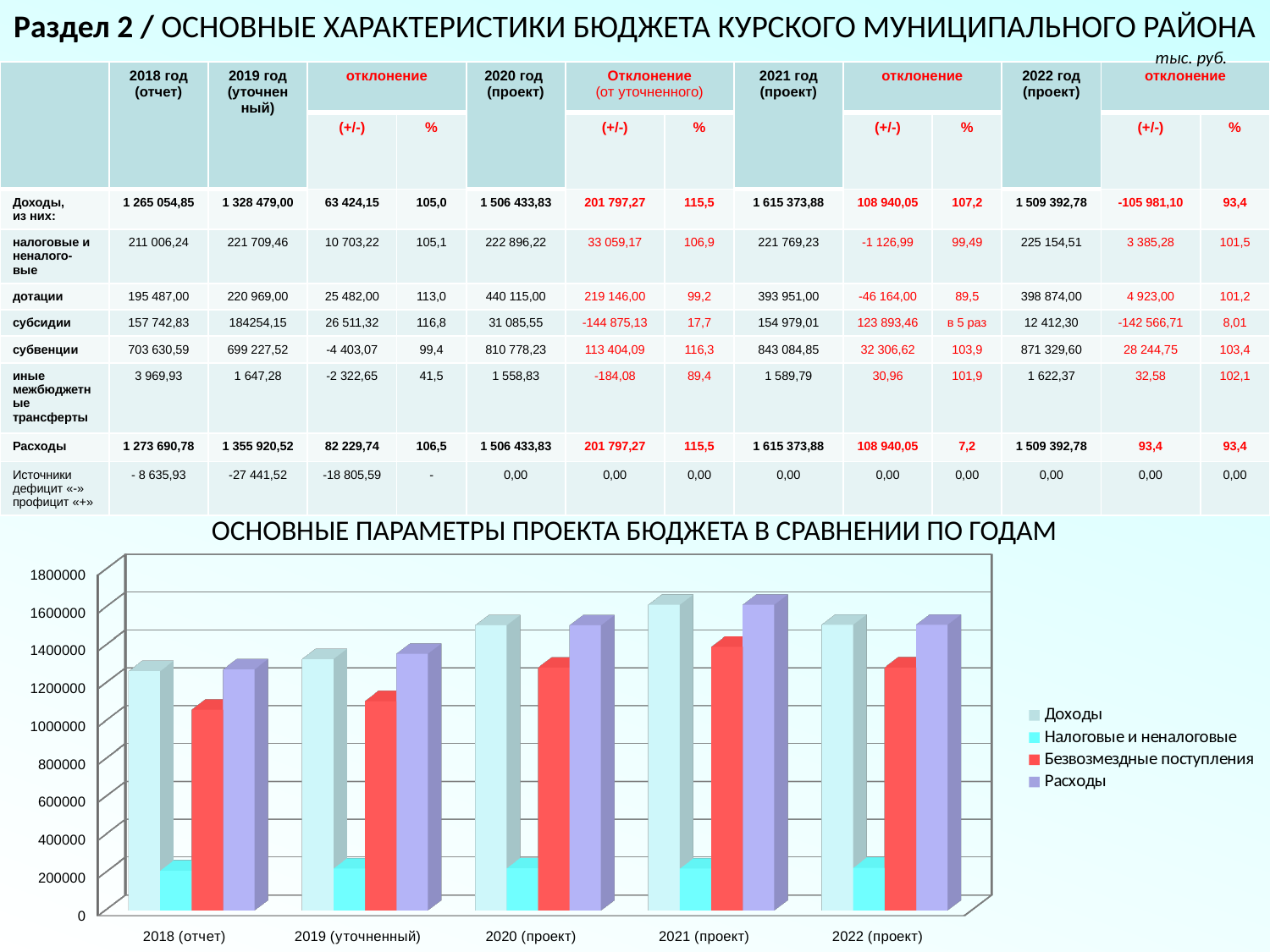
How many series does the legend of the bar chart list? 4 In the bar chart, which year has the highest value for Доходы? 2021 (проект) In the bar chart, which year has the lowest value for Доходы? 2018 (отчет) In the bar chart legend, which series is shown in red? Безвозмездные поступления In the bar chart, which is larger: Безвозмездные поступления in 2020 (проект) or in 2018 (отчет)? 2020 (проект) In the bar chart, is the value for Безвозмездные поступления in 2021 (проект) greater or less than 1200000? greater In the bar chart, is the value for Расходы in 2019 (уточненный) greater or less than 1200000? greater What kind of chart is shown under the title "ОСНОВНЫЕ ПАРАМЕТРЫ ПРОЕКТА БЮДЖЕТА В СРАВНЕНИИ ПО ГОДАМ"? bar chart In the bar chart, is the value for Налоговые и неналоговые in 2020 (проект) greater or less than 400000? less In the bar chart, do the values for Доходы rise or fall from 2018 (отчет) to 2021 (проект)? rise How many year categories are shown on the x axis of the bar chart? 5